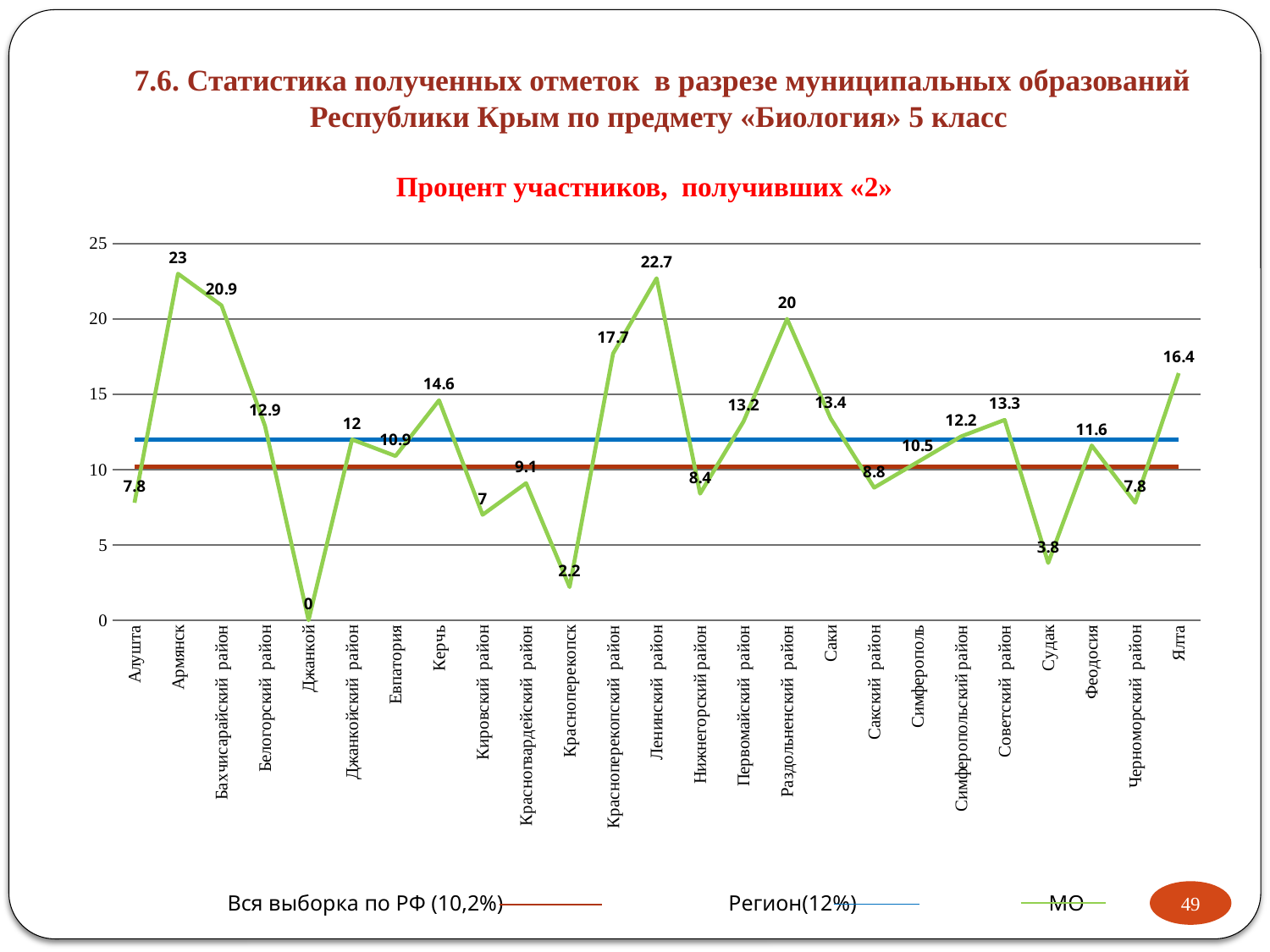
Which municipality has the lowest percentage of participants who received «2»? Джанкой What is the difference between the values for Армянск and Бахчисарайский район? 2.1 How many municipalities are plotted on the x axis? 25 What type of chart is shown on the slide? line chart What is the value for Ленинский район? 22.7 Is the value for Раздольненский район greater or less than 15? greater What is the value for Судак? 3.8 What is the percentage of participants who received «2» in Армянск? 23 Which has a higher value, Керчь or Евпатория? Керчь How many series does the legend list? 3 Which municipality has the highest percentage of participants who received «2»? Армянск What value does the legend give for the series «Регион»? 12%